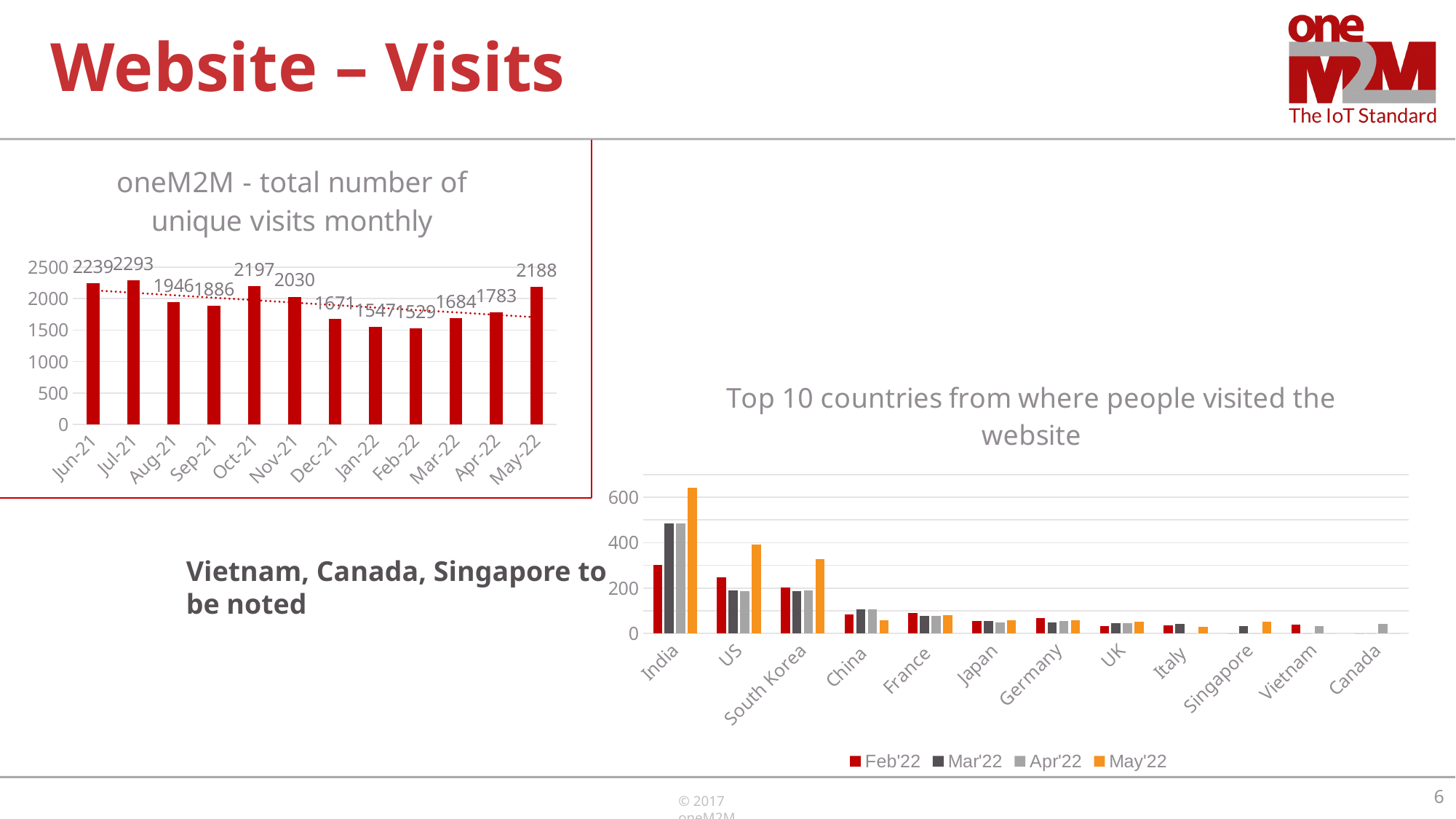
In the 'oneM2M - total number of unique visits monthly' chart, which month has the lowest value? Feb-22 In the 'oneM2M - total number of unique visits monthly' chart, which month has the highest value? Jul-21 In the 'oneM2M - total number of unique visits monthly' chart, what is the value for Jul-21? 2293 In the 'oneM2M - total number of unique visits monthly' chart, what is the difference between the values for May-22 and Apr-22? 405 In the 'oneM2M - total number of unique visits monthly' chart, which is larger, the value for Oct-21 or Nov-21? Oct-21 In the 'oneM2M - total number of unique visits monthly' chart, what is the value for May-22? 2188 In the 'Top 10 countries from where people visited the website' chart, is the May'22 value for India greater or less than 600? greater How many months are shown in the 'oneM2M - total number of unique visits monthly' chart? 12 In the 'Top 10 countries from where people visited the website' chart, is the May'22 value for South Korea greater or less than 400? less How many series does the legend list in the 'Top 10 countries from where people visited the website' chart? 4 In the 'Top 10 countries from where people visited the website' chart, which country has the highest May'22 value? India What kind of chart is the 'oneM2M - total number of unique visits monthly' chart? Bar chart